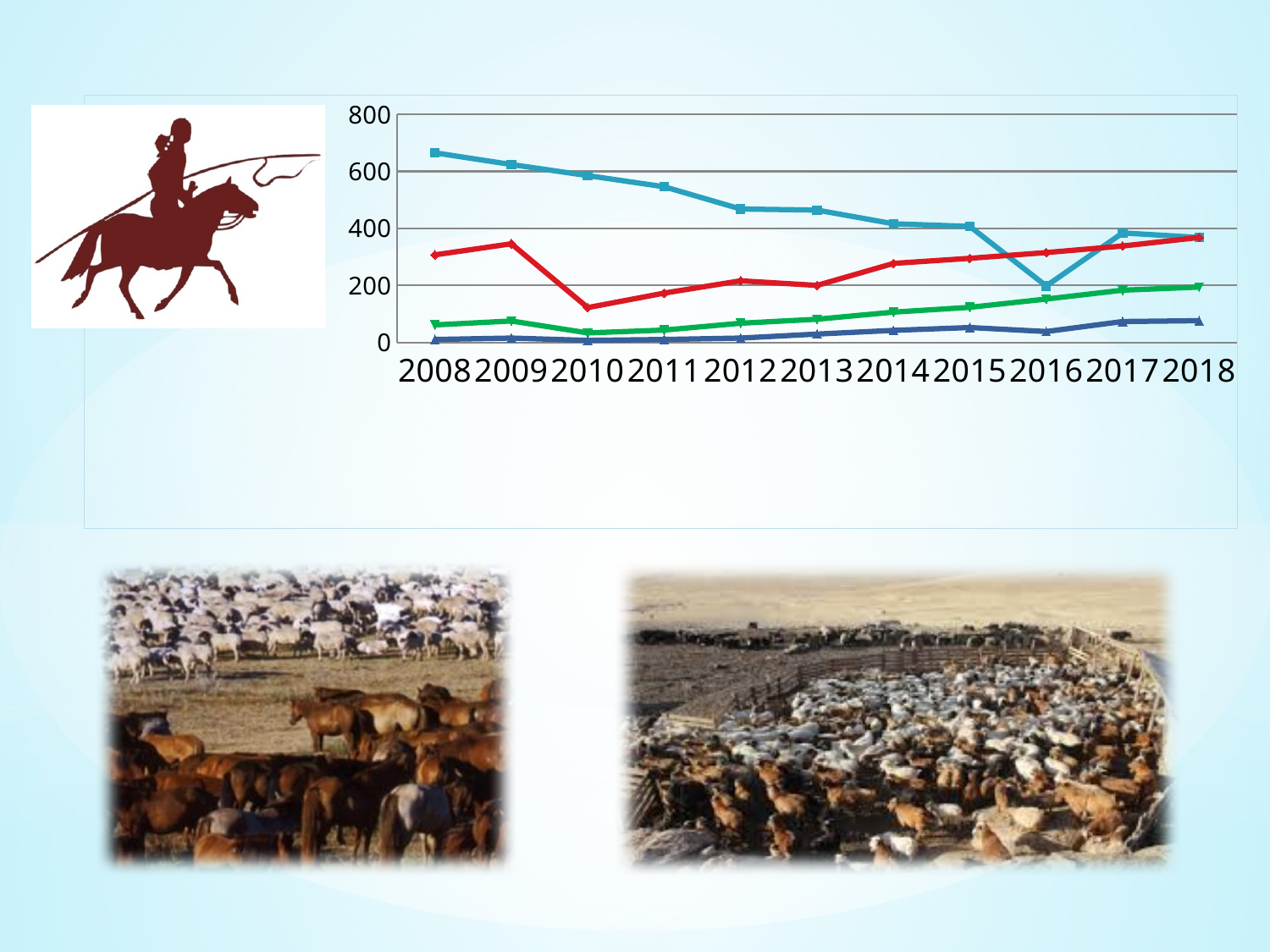
How many years are shown along the x axis of the chart? 11 What kind of chart is shown on the slide? line chart In 2012, which is larger: the value of the red line or the value of the green line? the red line Which line has the highest value in 2008? the light blue line What is the first year shown on the x axis of the chart? 2008 What is the highest value shown on the y axis of the chart? 800 How many lines are plotted on the chart? 4 Is the value of the red line in 2010 greater or less than 200? less Is the value of the light blue line in 2008 greater or less than 600? greater Which line has the lowest value in 2018? the dark blue line Does the light blue line generally rise or fall from 2008 to 2016? fall Does the green line rise or fall from 2010 to 2018? rise